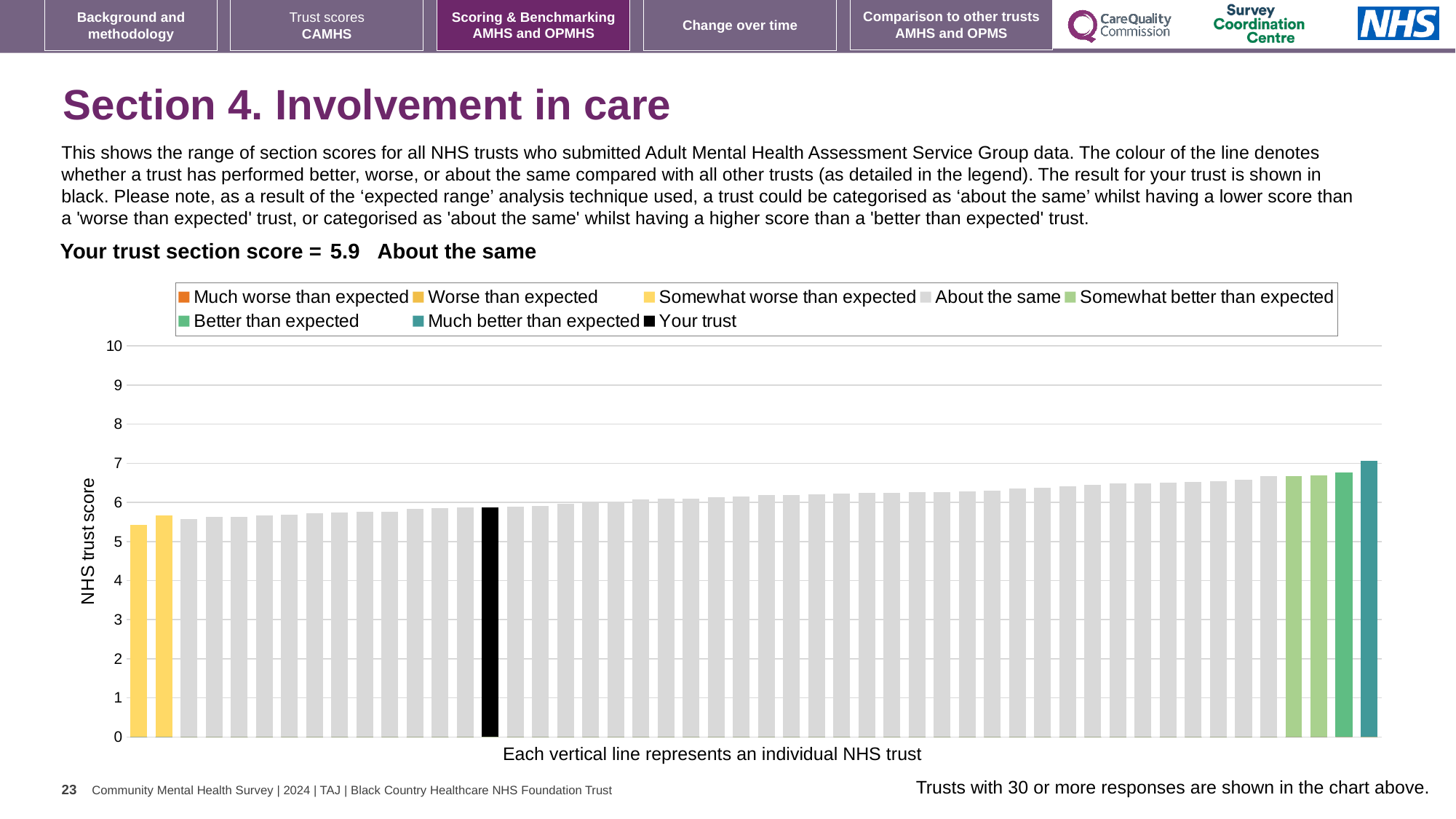
Is the value of the lowest bar in the chart greater or less than 5? greater What is the section score for your trust, as printed on the slide? 5.9 What kind of chart is shown on the slide? Bar chart Which category does your trust fall into according to the text above the chart? About the same Is the value of the highest bar in the chart greater or less than 8? less Which legend category does the colour of the tallest bar correspond to? Much better than expected Is the value of the lowest bar in the chart greater or less than 6? less What is the label on the vertical axis of the chart? NHS trust score How many entries does the chart legend list? 8 How many bars are coloured 'Worse than expected' (yellow)? 0 Do the bar values rise or fall from left to right along the x axis? Rise